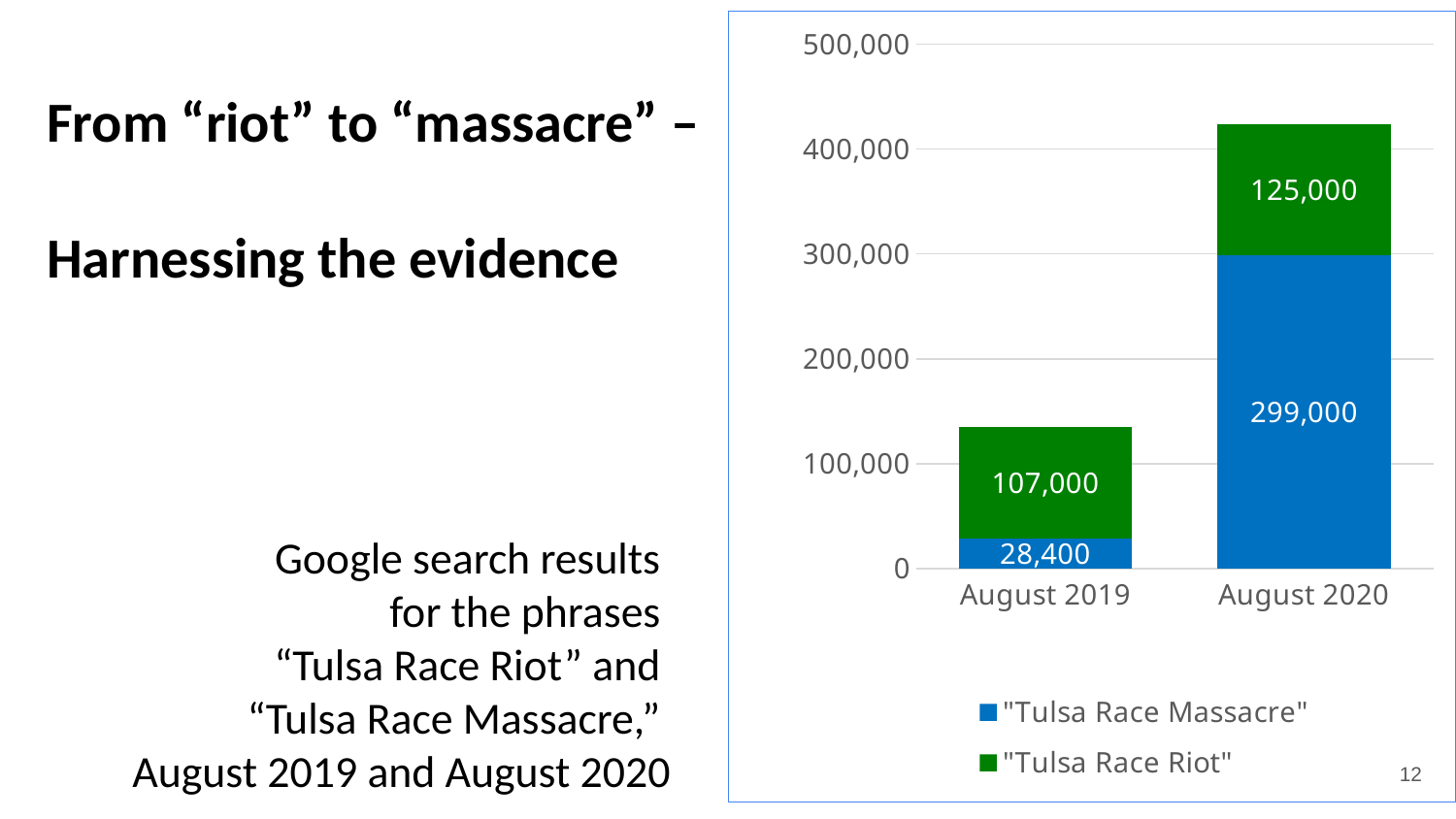
What is the difference between the "Tulsa Race Massacre" values for August 2020 and August 2019? 270,600 What is the value for "Tulsa Race Massacre" in August 2020? 299,000 What is the value for "Tulsa Race Riot" in August 2019? 107,000 Which series has the larger value in August 2019, "Tulsa Race Massacre" or "Tulsa Race Riot"? "Tulsa Race Riot" What is the value for "Tulsa Race Massacre" in August 2019? 28,400 What is the total of the stacked bar for August 2019? 135,400 What is the total of the stacked bar for August 2020? 424,000 What is the value for "Tulsa Race Riot" in August 2020? 125,000 Which category has the highest total bar? August 2020 What kind of chart is shown on the slide? Stacked bar chart How many categories are shown on the x axis? 2 How many series does the legend list? 2